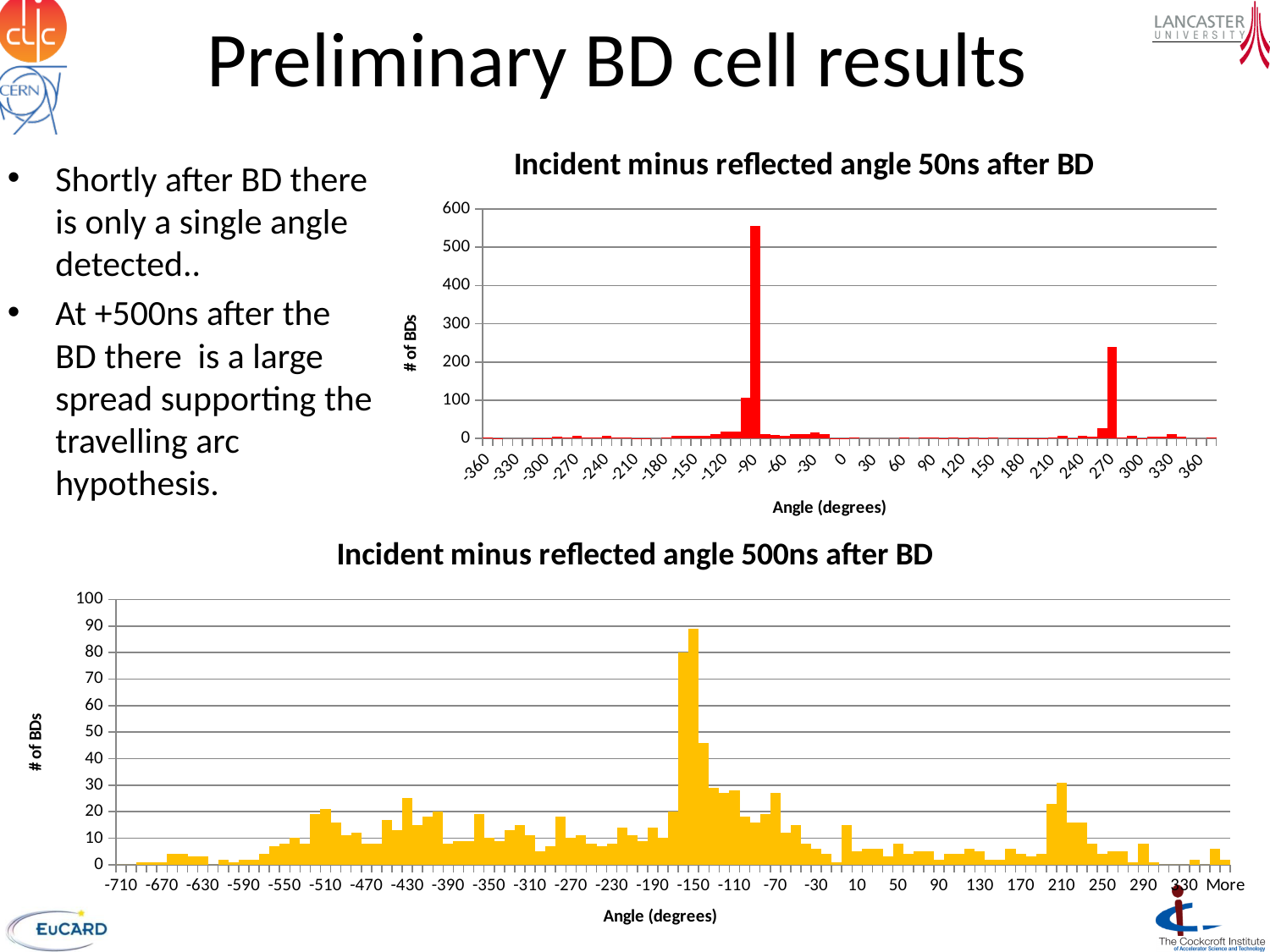
What is the x-axis label of the bottom chart (500ns after BD)? Angle (degrees) In the top chart (50ns after BD), near which angle on the x axis is the tallest bar? -90 In the bottom chart (500ns after BD), is the bar near 90 degrees greater or less than 10? less In the top chart (50ns after BD), is the bar at 0 degrees greater or less than 100? less In the bottom chart (500ns after BD), is the bar near 210 degrees greater or less than 20? greater What is the y-axis label of the top chart (50ns after BD)? # of BDs In the top chart (50ns after BD), which bar is taller: the one near -90 degrees or the one near 270 degrees? -90 What kind of chart is the top chart titled 'Incident minus reflected angle 50ns after BD'? bar chart In the bottom chart (500ns after BD), near which angle on the x axis is the tallest bar? -150